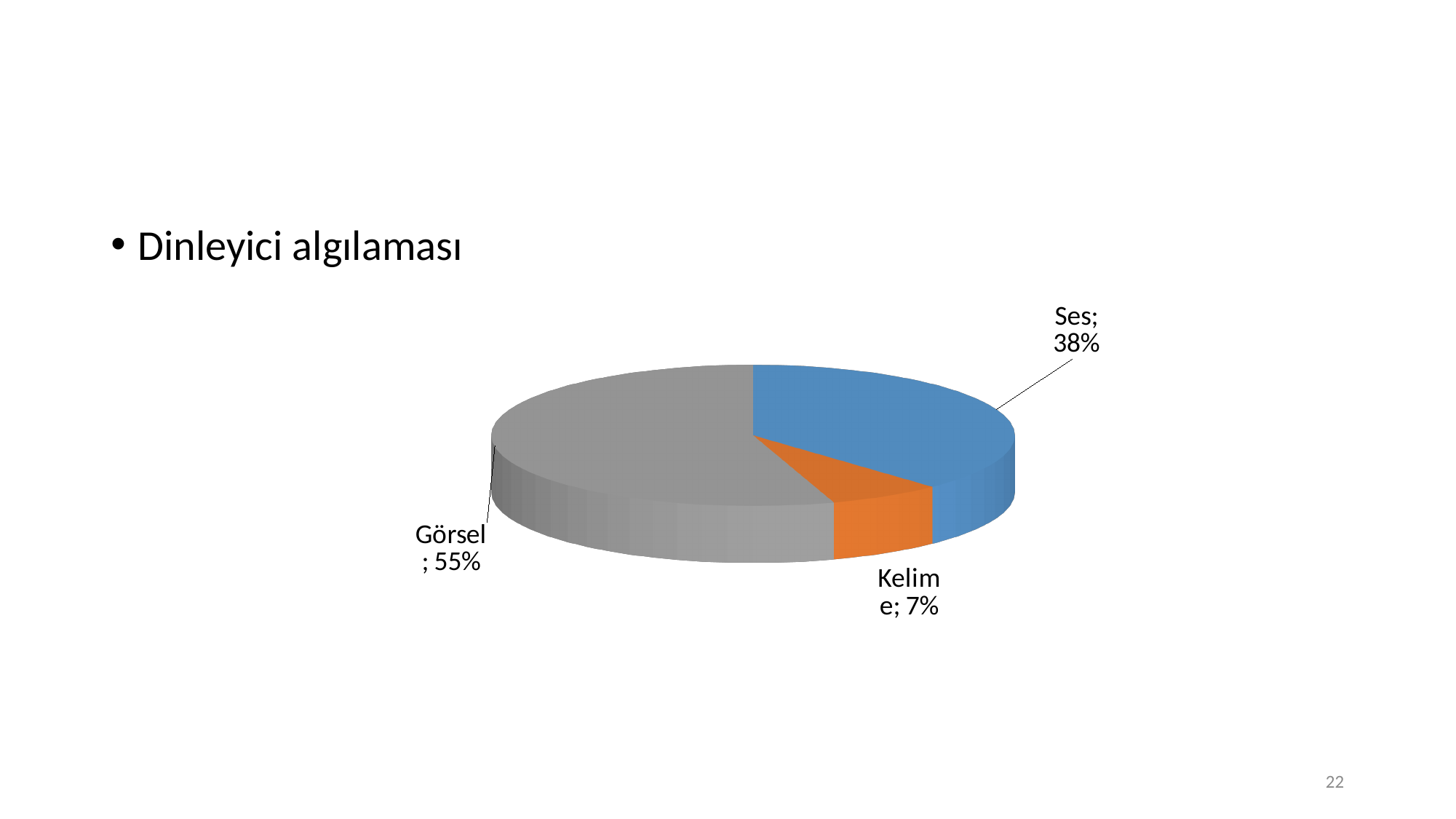
What is the difference between the values for Görsel and Ses? 17% Which category has the smallest slice? Kelime What is the value for Ses? 38% What colour is the Ses slice? blue What is the difference between the values for Ses and Kelime? 31% What colour is the Görsel slice? grey Which is larger, the value for Ses or the value for Kelime? Ses What is the value for Kelime? 7% What kind of chart is shown on the slide? pie chart What is the value for Görsel? 55% Which category has the largest slice? Görsel How many slices does the pie chart have? 3